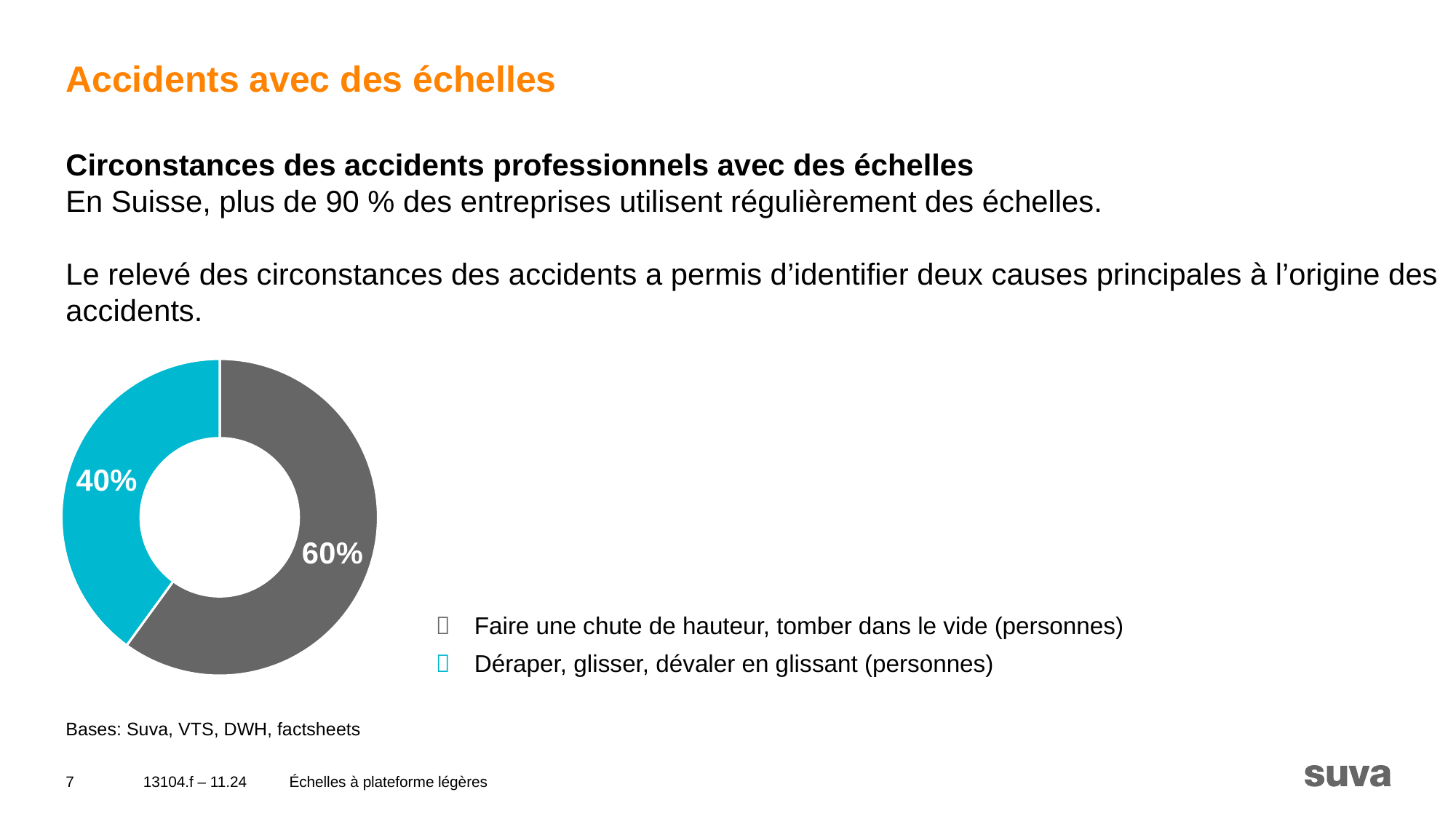
How many slices does the pie chart have? 2 What is the difference in percentage points between the two slices of the pie? 20 percentage points What kind of chart is shown on the slide? Pie chart (donut) What colour is the slice labelled 60%? Grey Which category has the smallest slice of the pie? Déraper, glisser, dévaler en glissant (personnes) Which category has the largest slice of the pie? Faire une chute de hauteur, tomber dans le vide (personnes) What colour is the slice labelled 40%? Cyan (light blue) What share of the pie is labelled for "Faire une chute de hauteur, tomber dans le vide (personnes)"? 60% Which is larger: the slice for falling from height or the slice for slipping? Falling from height (Faire une chute de hauteur, tomber dans le vide) How many entries does the legend list? 2 What share of the pie is labelled for "Déraper, glisser, dévaler en glissant (personnes)"? 40% What is the total of the two slices shown in the pie chart? 100%